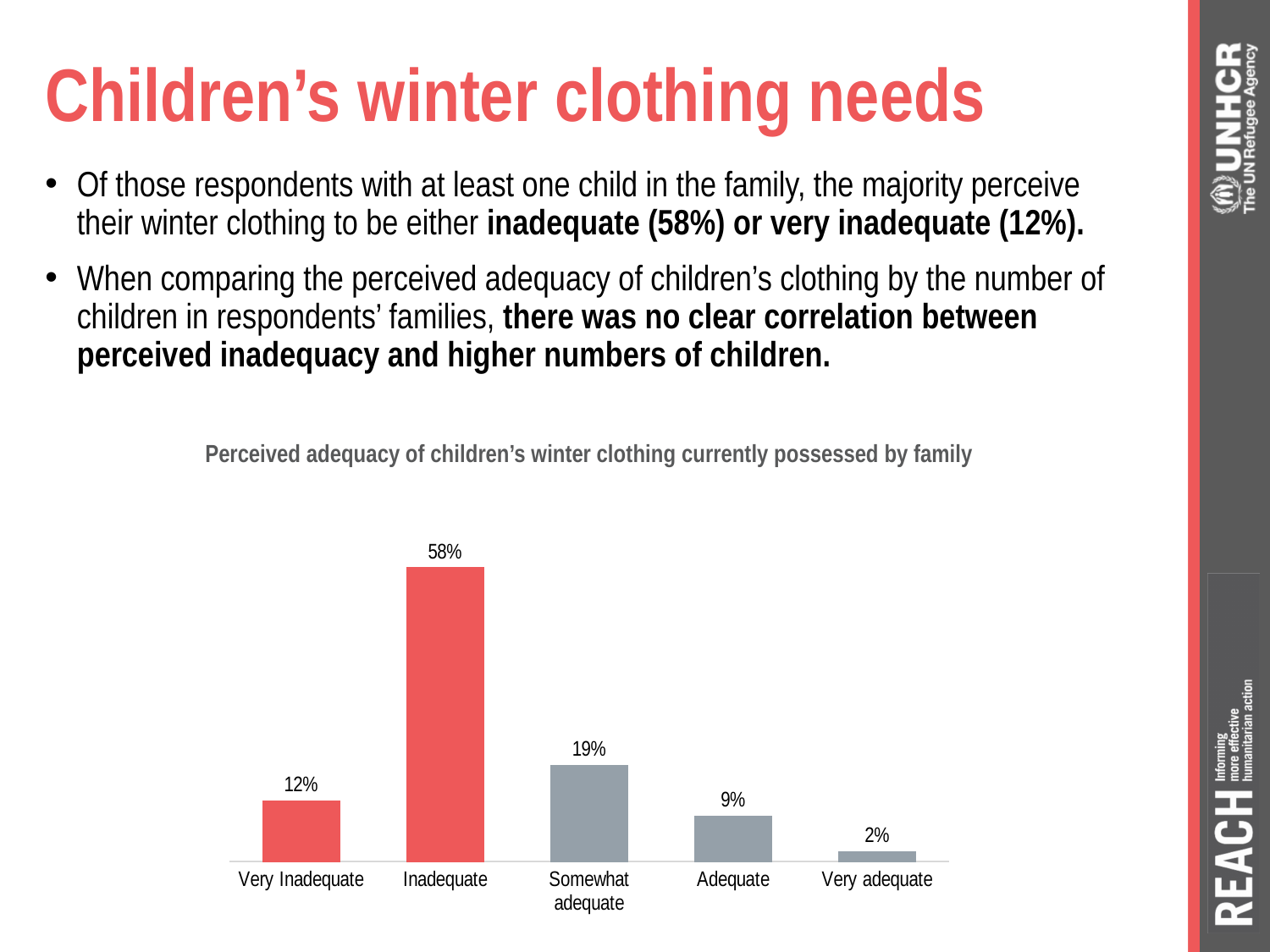
What is the value shown for Somewhat adequate? 19% What percentage of respondents perceived their children's winter clothing as Inadequate? 58% Which is larger, the value for Very Inadequate or the value for Adequate? Very Inadequate What is the value shown for Very adequate? 2% Which category has the lowest value? Very adequate What kind of chart is shown on the slide? Bar chart What is the value shown for Very Inadequate? 12% What is the difference in percentage points between Inadequate and Somewhat adequate? 39 Which category has the highest value? Inadequate How many categories are shown on the x axis of the chart? 5 Which bars in the chart are coloured red? Very Inadequate and Inadequate What is the title of the chart? Perceived adequacy of children's winter clothing currently possessed by family